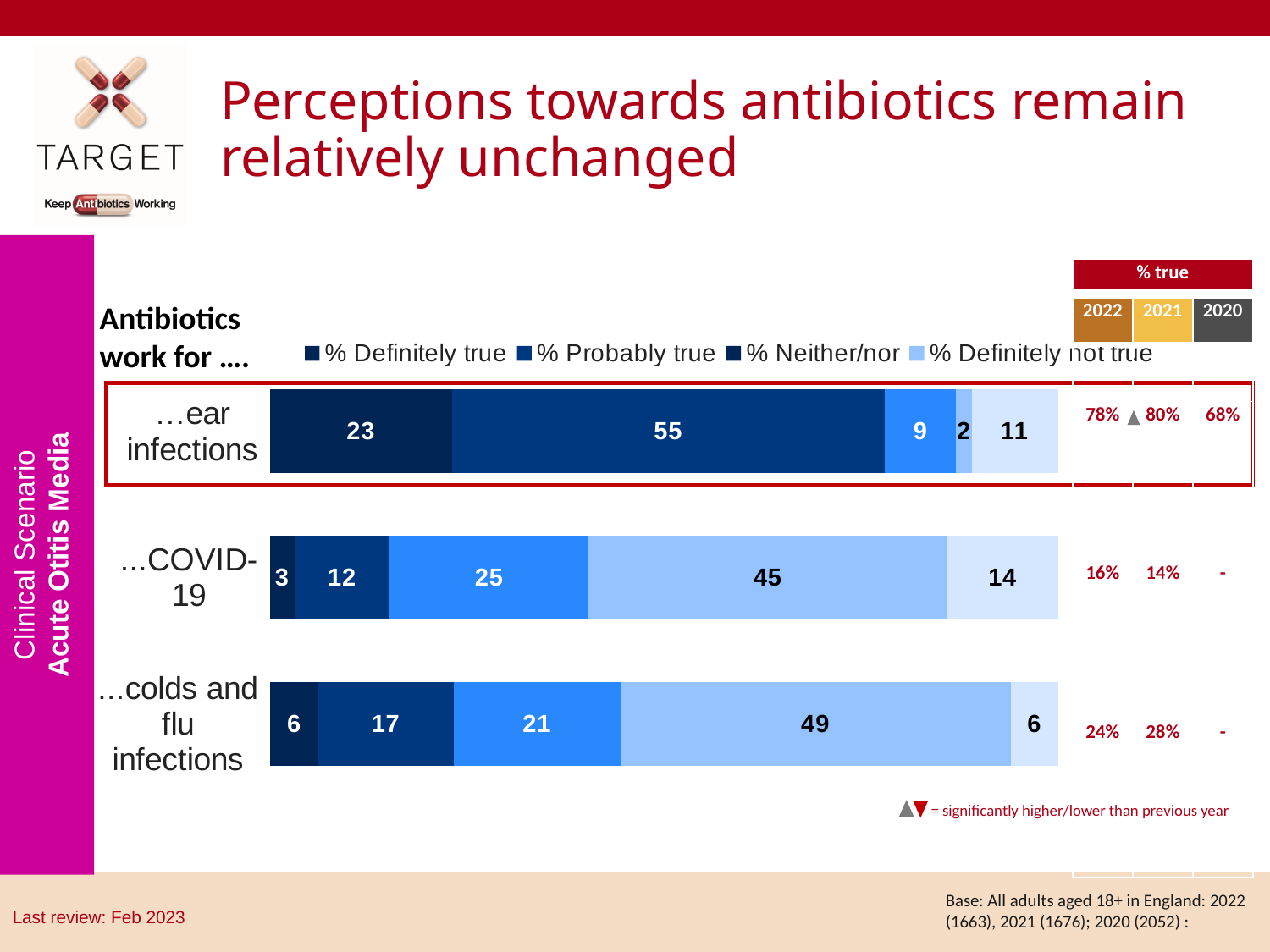
How many categories are shown in the chart? 3 Which category has the highest % Definitely true value? ear infections What is the % Definitely not true value for colds and flu infections? 49 What is the % Definitely true value for ear infections? 23 What is the % Probably true value for COVID-19? 12 What is the first entry listed in the chart legend? % Definitely true What is the total of all segments in the ear infections bar? 100 What is the difference between the % Probably true values for ear infections and colds and flu infections? 38 Which category has the lowest % Definitely true value? COVID-19 What kind of chart is shown on the slide? stacked bar chart